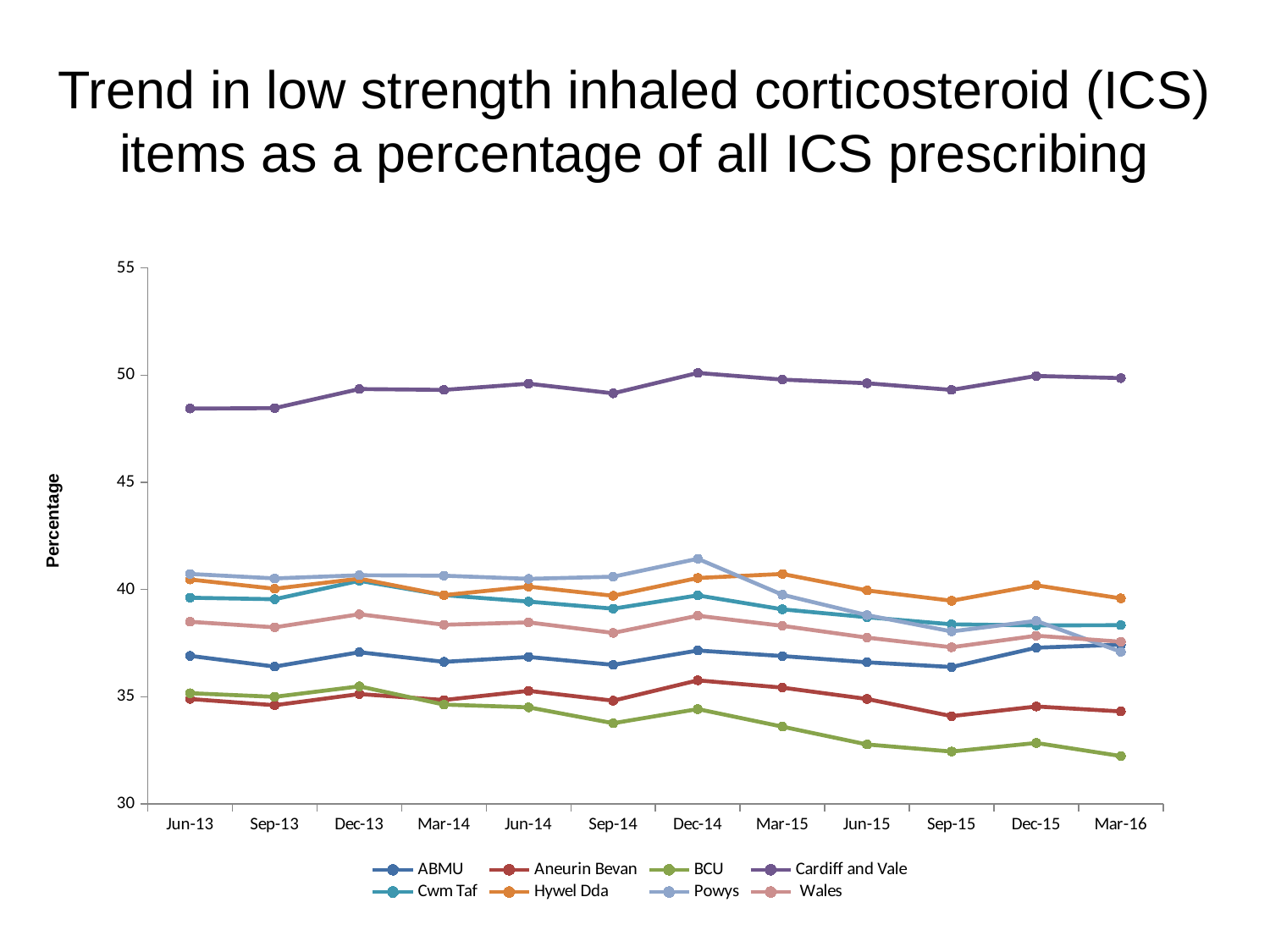
Is the value for BCU at Mar-16 greater or less than 35? less Is the value for ABMU at Sep-13 greater or less than 40? less At Dec-14, which is larger: the value for Powys or the value for Wales? Powys Which series has the lowest value at Mar-16? BCU How many time points are shown along the x axis? 12 Which series has the highest values across the whole period? Cardiff and Vale What kind of chart is shown on the slide? line chart What is the label on the y axis? Percentage How many series does the legend list? 8 What is the title of the slide? Trend in low strength inhaled corticosteroid (ICS) items as a percentage of all ICS prescribing Is the value for Cardiff and Vale at Jun-13 greater or less than 45? greater Does the BCU line rise or fall overall from Jun-13 to Mar-16? fall